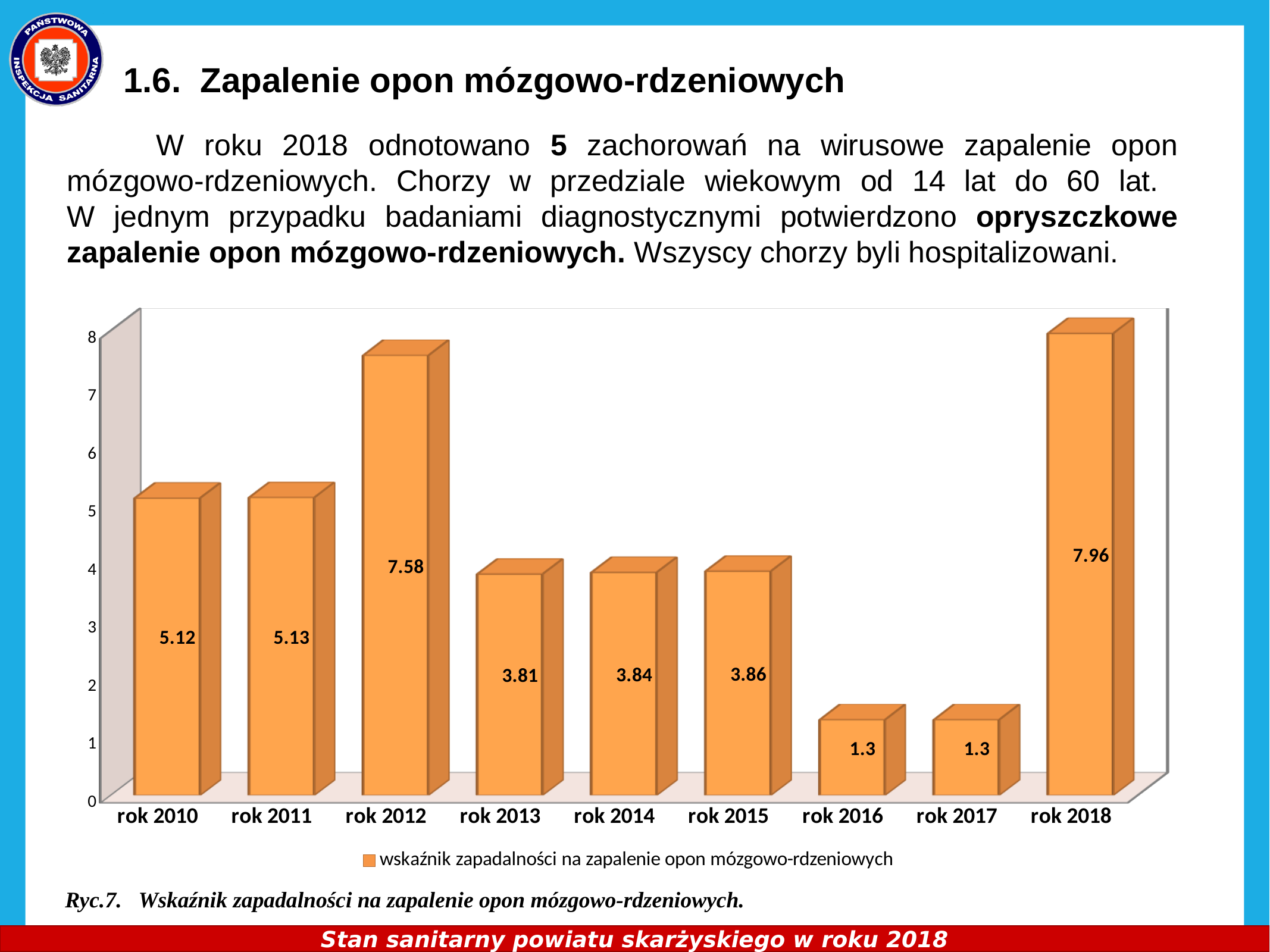
What is the value for rok 2018? 7.96 How many years are shown on the x axis? 9 What is the value for rok 2012? 7.58 What kind of chart is shown? bar chart Which is larger, the value for rok 2010 or the value for rok 2013? rok 2010 What is the difference between the values for rok 2011 and rok 2017? 3.83 Which year has the highest value? rok 2018 What is the difference between the values for rok 2018 and rok 2012? 0.38 Is the value for rok 2015 greater or less than 3? greater What is the value for rok 2016? 1.3 How many series does the legend list? 1 What is the legend entry for the series? wskaźnik zapadalności na zapalenie opon mózgowo-rdzeniowych